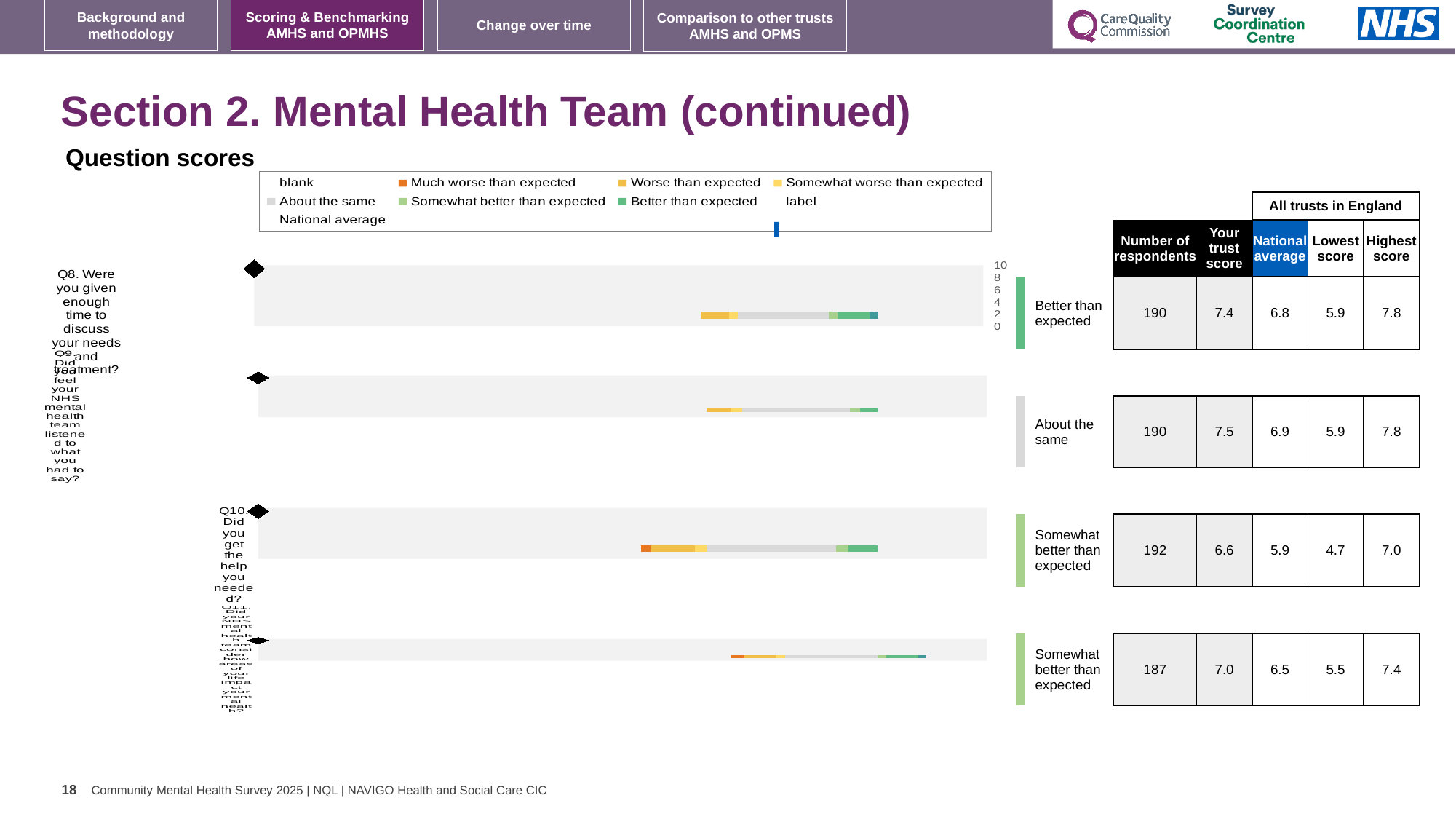
How many questions (bars) are plotted in the question scores chart? 4 In the table beside the chart, what is the difference between the trust score and the national average for the Q8 row? 0.6 In the legend of the question scores chart, what colour represents 'Much worse than expected'? orange How many entries does the legend of the question scores chart list? 9 In the table beside the chart, what is the 'Your trust score' for the Q8 row (Better than expected)? 7.4 In the table beside the chart, what is the number of respondents for the Q10 row (Somewhat better than expected, 6.6)? 192 What is the first question label shown at the top of the question scores chart? Q8. Were you given enough time to discuss your needs and treatment? What kind of chart is used to show the question scores on this slide? bar chart In the table beside the chart, which row has the highest 'Your trust score'? Q9 (About the same), 7.5 In the table beside the chart, is the trust score for the Q9 row (7.5) larger or smaller than the trust score for the Q10 row (6.6)? larger In the table beside the chart, which row has the lowest number of respondents? Q11, 187 In the table beside the chart, what is the national average for the Q11 row (trust score 7.0)? 6.5